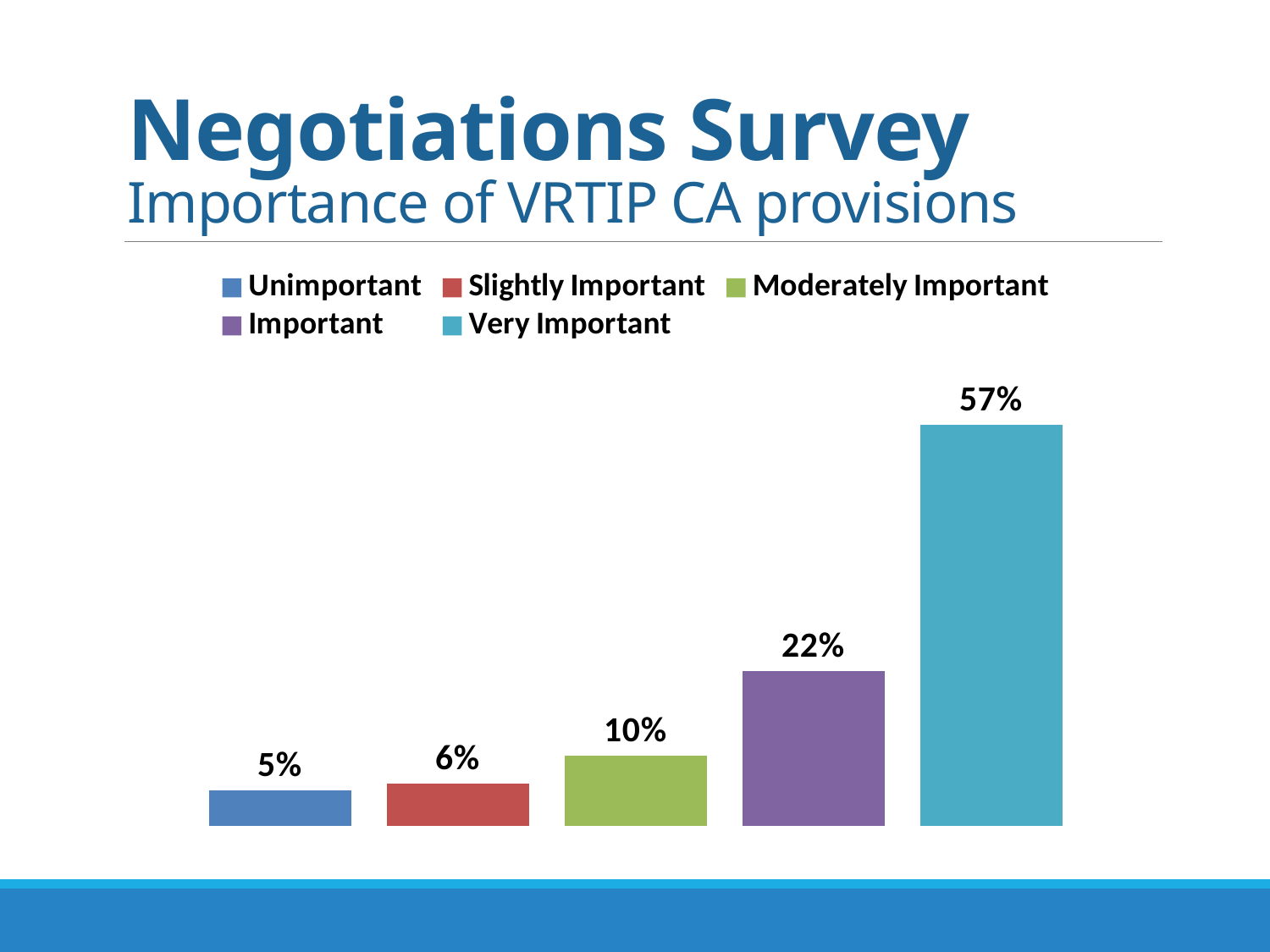
What is the difference between the Very Important and Important percentages? 35% Which rating category has the highest percentage? Very Important Which rating category has the lowest percentage? Unimportant What is the difference between the Slightly Important and Unimportant percentages? 1% What percentage of respondents rated the VRTIP CA provisions as Very Important? 57% What is the value shown for Important? 22% Which is larger, the value for Important or the value for Moderately Important? Important What kind of chart is shown on the slide? Bar chart What is the value shown for Moderately Important? 10% What percentage of respondents rated the provisions as Unimportant? 5% How many rating categories are plotted in the chart? 5 Do the values rise or fall moving from left to right across the bars? Rise